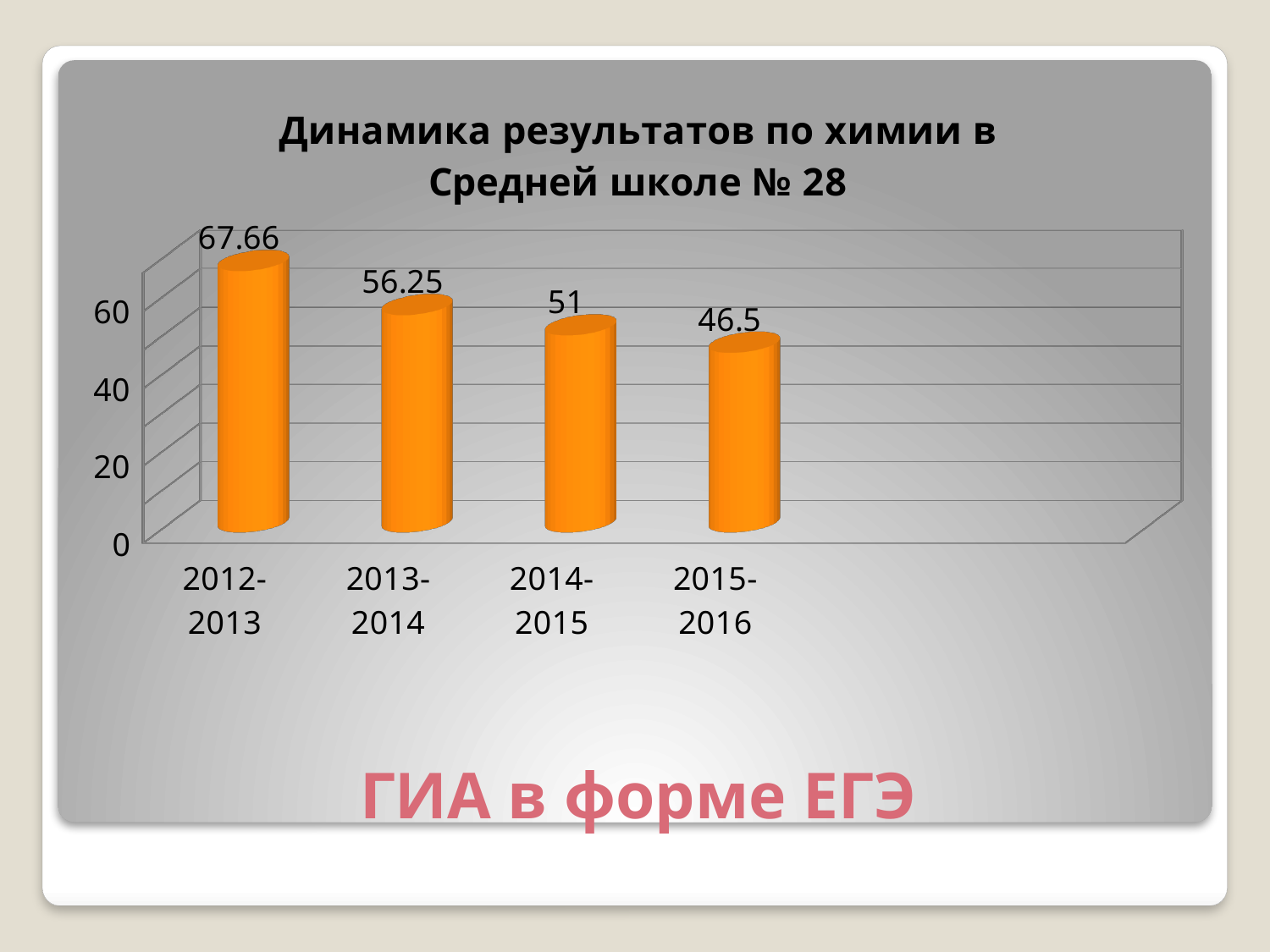
What is the value for 2014-2015? 51 What kind of chart is this? bar chart What is the difference between the values for 2013-2014 and 2014-2015? 5.25 What is the value for 2013-2014? 56.25 What is the value for 2012-2013? 67.66 Which is larger, the value for 2013-2014 or the value for 2015-2016? 2013-2014 What is the difference between the values for 2012-2013 and 2015-2016? 21.16 Which school year has the highest value? 2012-2013 Do the values rise or fall from 2012-2013 to 2015-2016? fall What is the value for 2015-2016? 46.5 How many school years are shown on the chart? 4 Which school year has the lowest value? 2015-2016